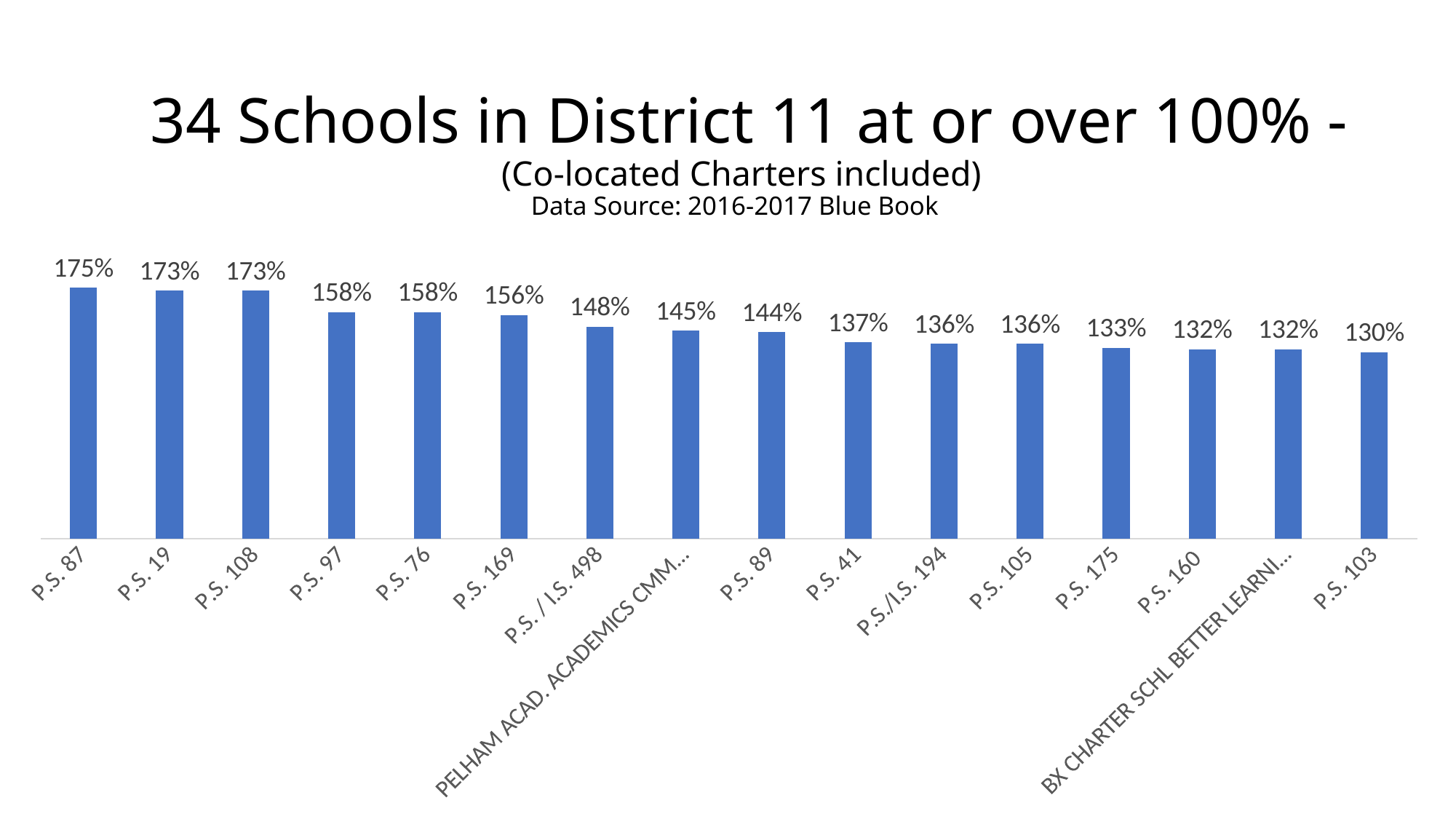
Which school has the lowest value? P.S. 103 What is the value for P.S. 87? 175% What is the value for P.S. 89? 144% Which has a larger value, P.S. / I.S. 498 or P.S. 175? P.S. / I.S. 498 What is the difference between the values for P.S. 87 and P.S. 103? 45% What is the value for P.S. 169? 156% What is the difference between the values for P.S. 97 and P.S. 41? 21% What is the value for P.S. 103? 130% What kind of chart is shown on the slide? Bar chart Which school has the highest value? P.S. 87 How many schools are shown in the chart? 16 Do the values rise or fall from left to right along the x axis? Fall